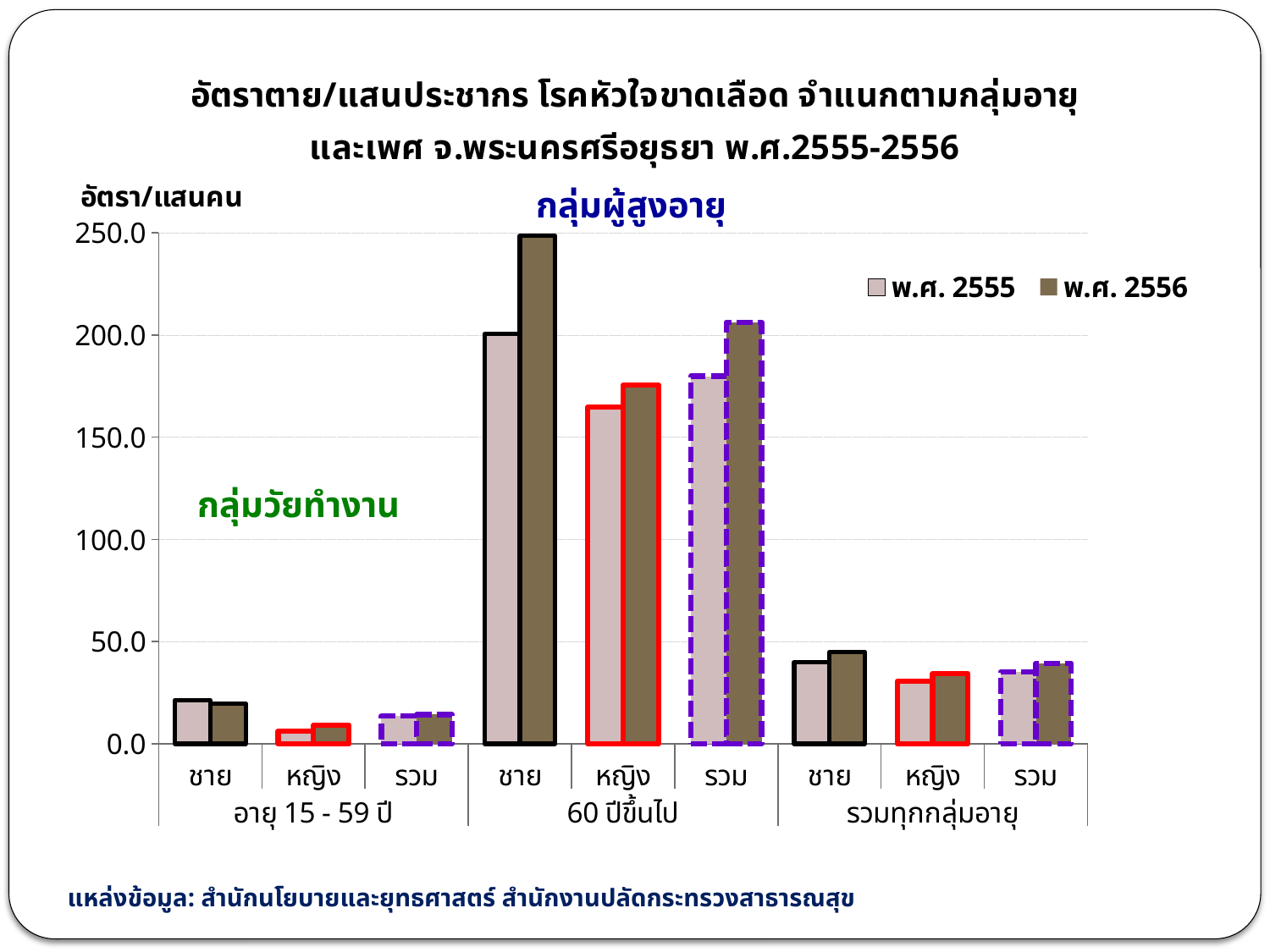
Is the value for ชาย in the 60 ปีขึ้นไป group for พ.ศ. 2556 greater or less than 200.0? greater Which bar is the highest in the chart? ชาย, 60 ปีขึ้นไป, พ.ศ. 2556 For ชาย in the 60 ปีขึ้นไป group, which year has the larger value, พ.ศ. 2555 or พ.ศ. 2556? พ.ศ. 2556 Which bar is the lowest in the chart? หญิง, อายุ 15 - 59 ปี, พ.ศ. 2555 Is the value for หญิง in the 60 ปีขึ้นไป group for พ.ศ. 2555 greater or less than 200.0? less What unit label is shown above the y axis? อัตรา/แสนคน Is the value for ชาย in the รวมทุกกลุ่มอายุ group for พ.ศ. 2556 greater or less than 50.0? less How many series does the legend list? 2 How many age groups are shown along the x axis? 3 How many categories (bar groups) are there along the x axis in total? 9 What kind of chart is shown on the slide? bar chart In the อายุ 15 - 59 ปี group for พ.ศ. 2555, which is larger, ชาย or หญิง? ชาย